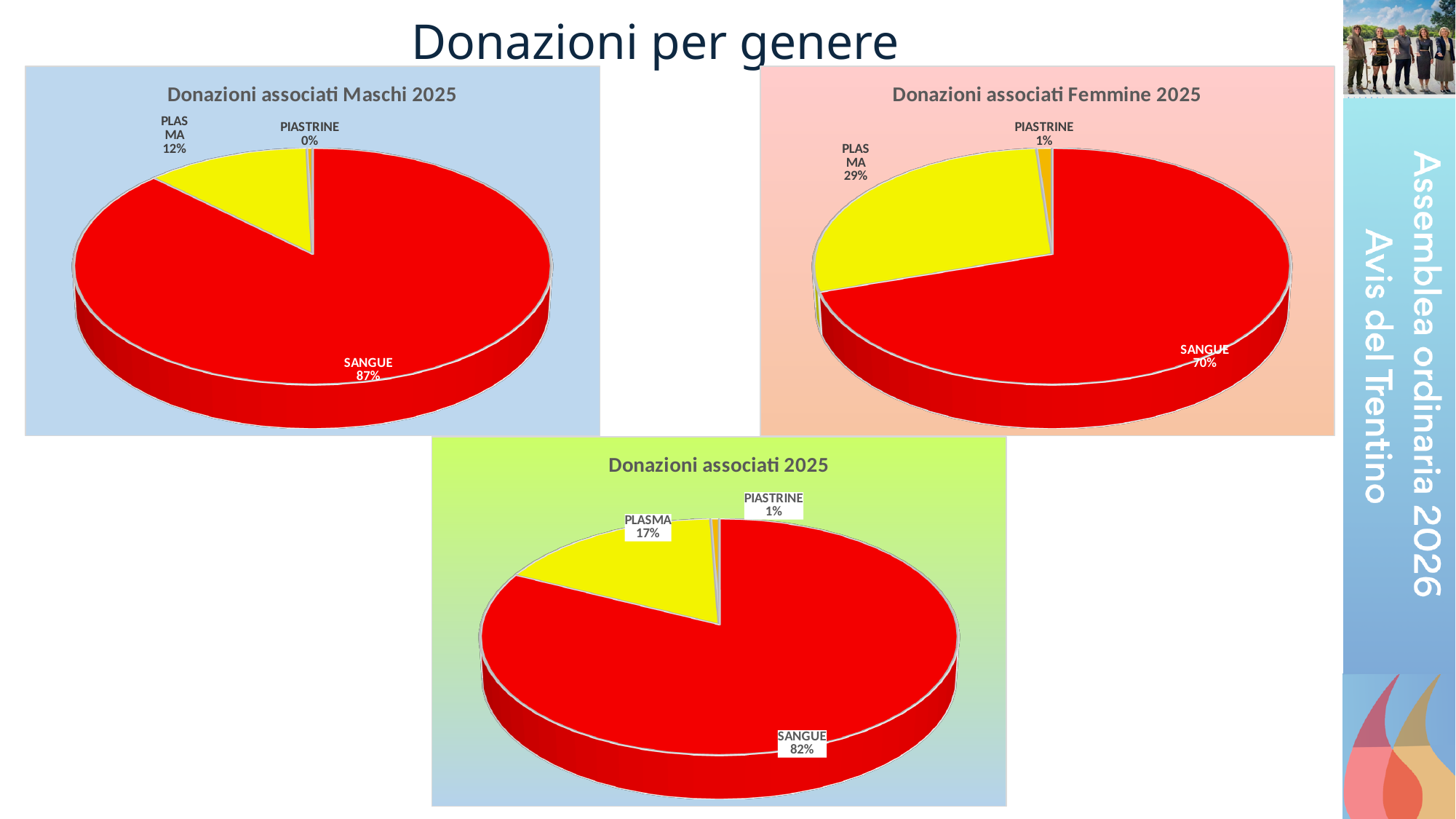
In the 'Donazioni associati Femmine 2025' chart, what share does PLASMA have? 29% In the 'Donazioni associati Femmine 2025' chart, what share does SANGUE have? 70% How many categories does the 'Donazioni associati 2025' chart show? 3 In the 'Donazioni associati 2025' chart, what share does SANGUE have? 82% What kind of chart is 'Donazioni associati 2025'? Pie chart In the 'Donazioni associati Femmine 2025' chart, which category has the smallest slice? PIASTRINE What is the difference between the PLASMA share in the 'Donazioni associati Femmine 2025' chart and the PLASMA share in the 'Donazioni associati Maschi 2025' chart? 17% In the 'Donazioni associati Maschi 2025' chart, which category has the largest slice? SANGUE Which is larger: the SANGUE share in the 'Donazioni associati Maschi 2025' chart or the SANGUE share in the 'Donazioni associati Femmine 2025' chart? Donazioni associati Maschi 2025